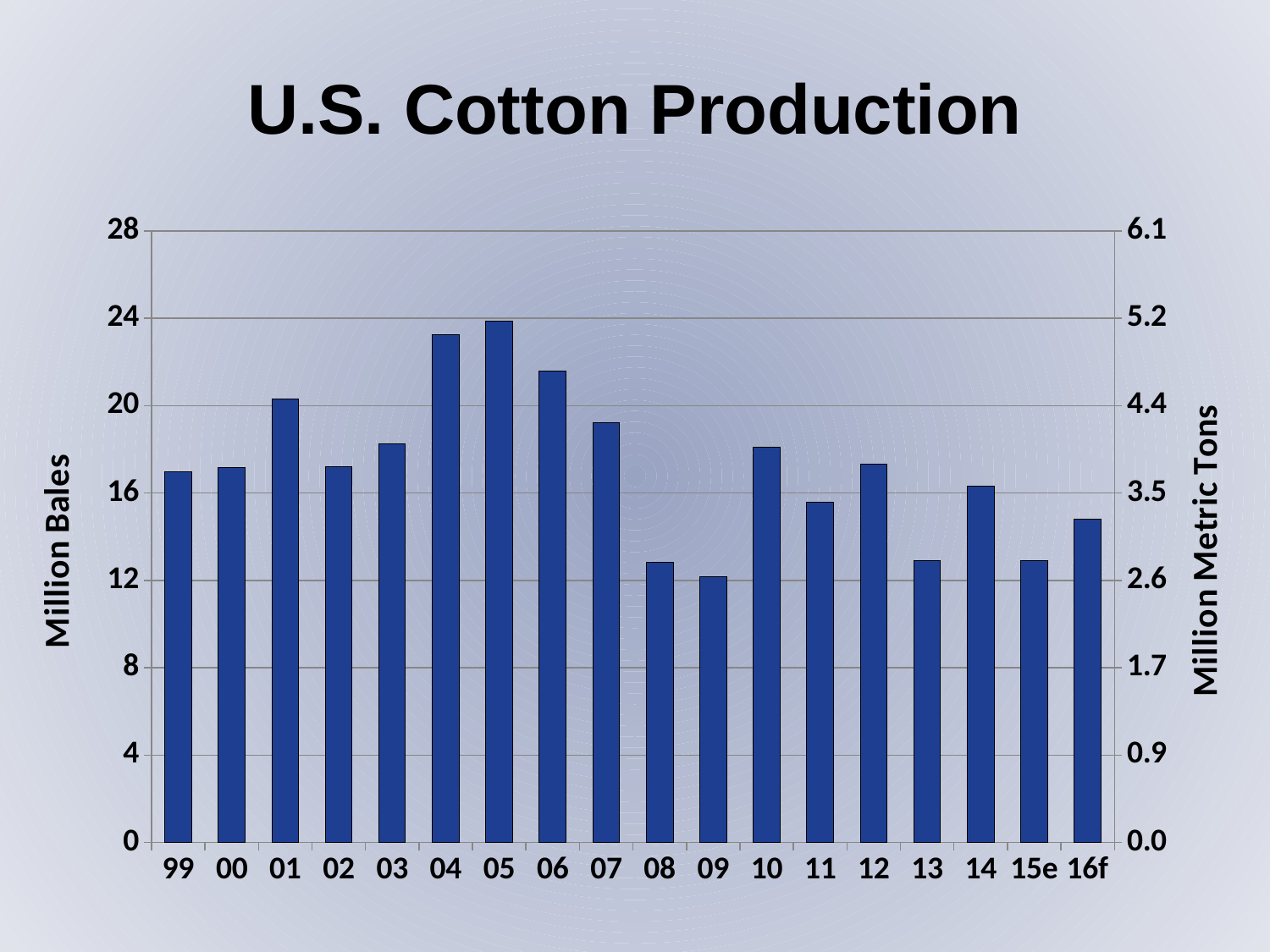
Which year has the highest U.S. cotton production? 05 Is the value for 09 greater or less than 16 million bales? less Is the value for 04 greater or less than 20 million bales? greater How many years (bars) are shown on the chart? 18 What kind of chart is shown on the slide? bar chart Is the value for 07 greater or less than 16 million bales? greater Which year has higher production, 04 or 08? 04 Which year has the lowest U.S. cotton production? 09 Do the values rise or fall from 05 to 09? fall What is the title of the left vertical axis? Million Bales Which year has higher production, 10 or 11? 10